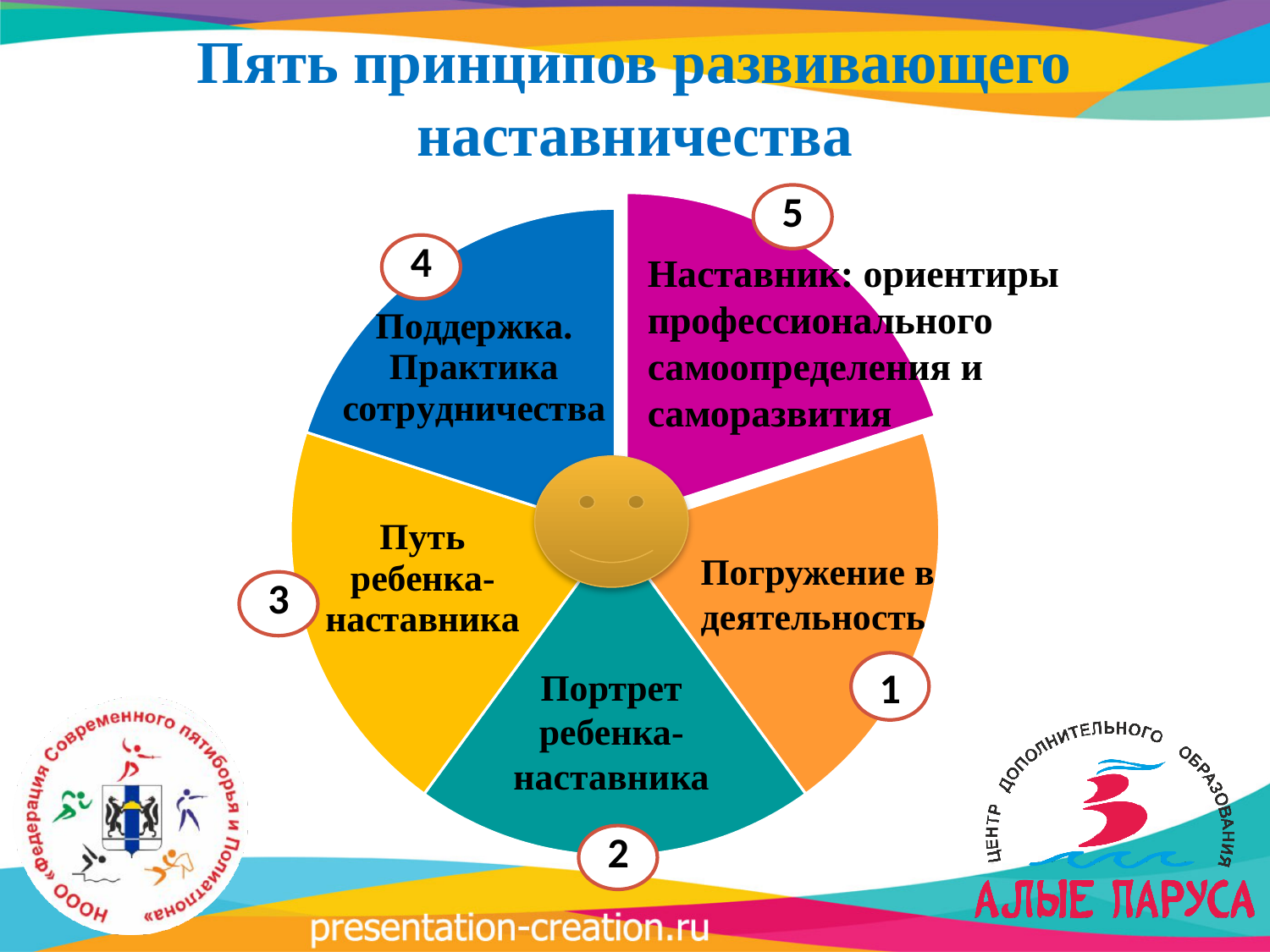
What number is assigned to the segment labelled "Путь ребенка-наставника"? 3 Which segment of the pie chart is numbered 3? Путь ребенка-наставника Which segment of the pie chart is numbered 2? Портрет ребенка-наставника Which segment of the pie chart is numbered 1? Погружение в деятельность Which segment of the pie chart is numbered 4? Поддержка. Практика сотрудничества What kind of chart is shown on the slide? pie chart Which segment of the pie chart is numbered 5? Наставник: ориентиры профессионального самоопределения и саморазвития What colour is the segment labelled "Погружение в деятельность"? orange What is the title of the slide above the pie chart? Пять принципов развивающего наставничества How many segments does the pie chart have? 5